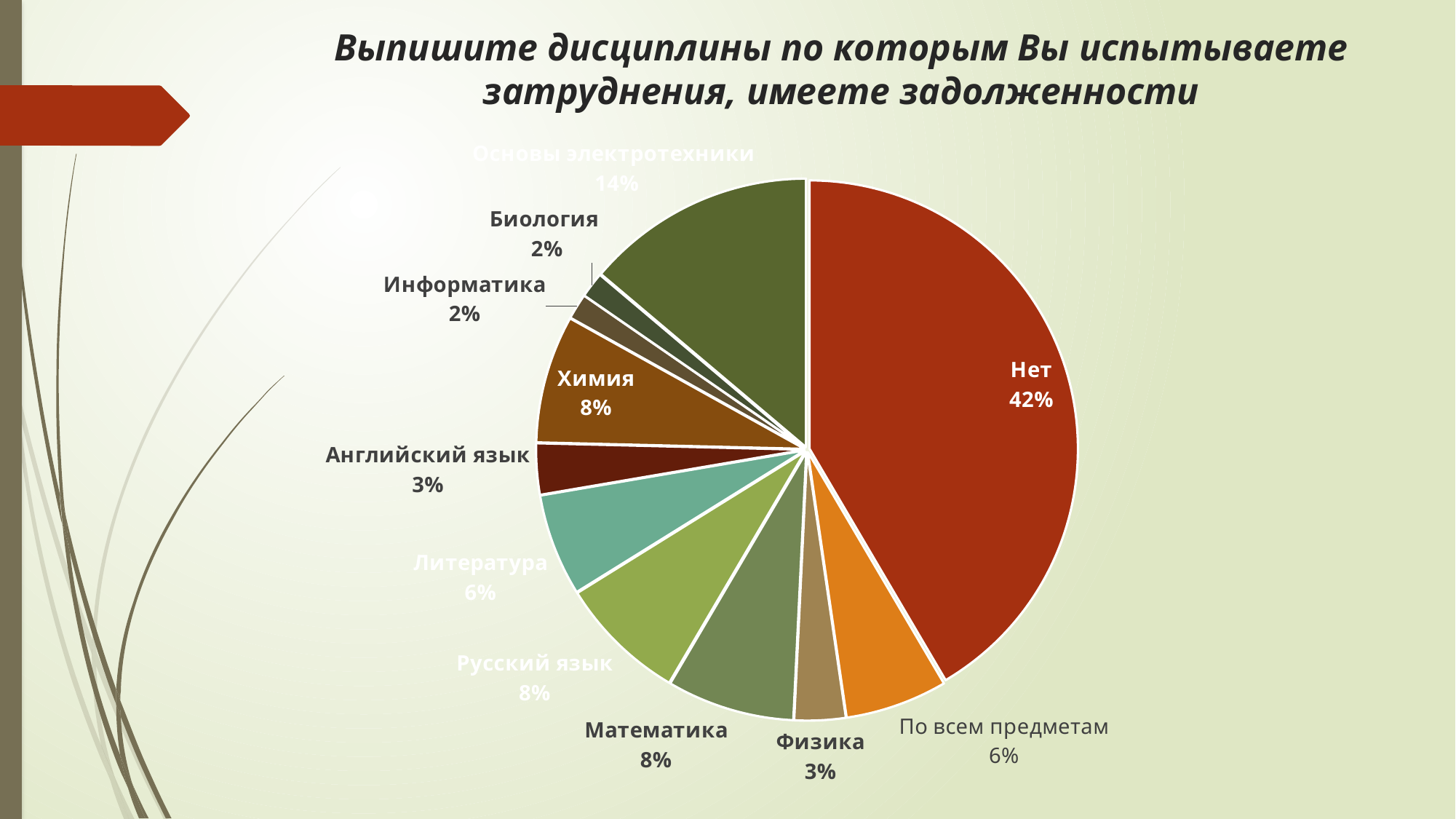
What is the difference between the values for "Нет" and "Основы электротехники"? 28% What is the value shown for "Основы электротехники"? 14% What is the value shown for "Химия"? 8% What is the difference between the values for "Математика" and "Биология"? 6% What is the value shown for "По всем предметам"? 6% How many categories (slices) does the pie chart have? 11 What share of the pie does the "Нет" slice represent? 42% What is the title of the chart on the slide? Выпишите дисциплины по которым Вы испытываете затруднения, имеете задолженности Which is larger, the value for "Литература" or the value for "Физика"? Литература Which category has the largest slice of the pie? Нет What type of chart is shown on the slide? pie chart What is the value shown for "Английский язык"? 3%